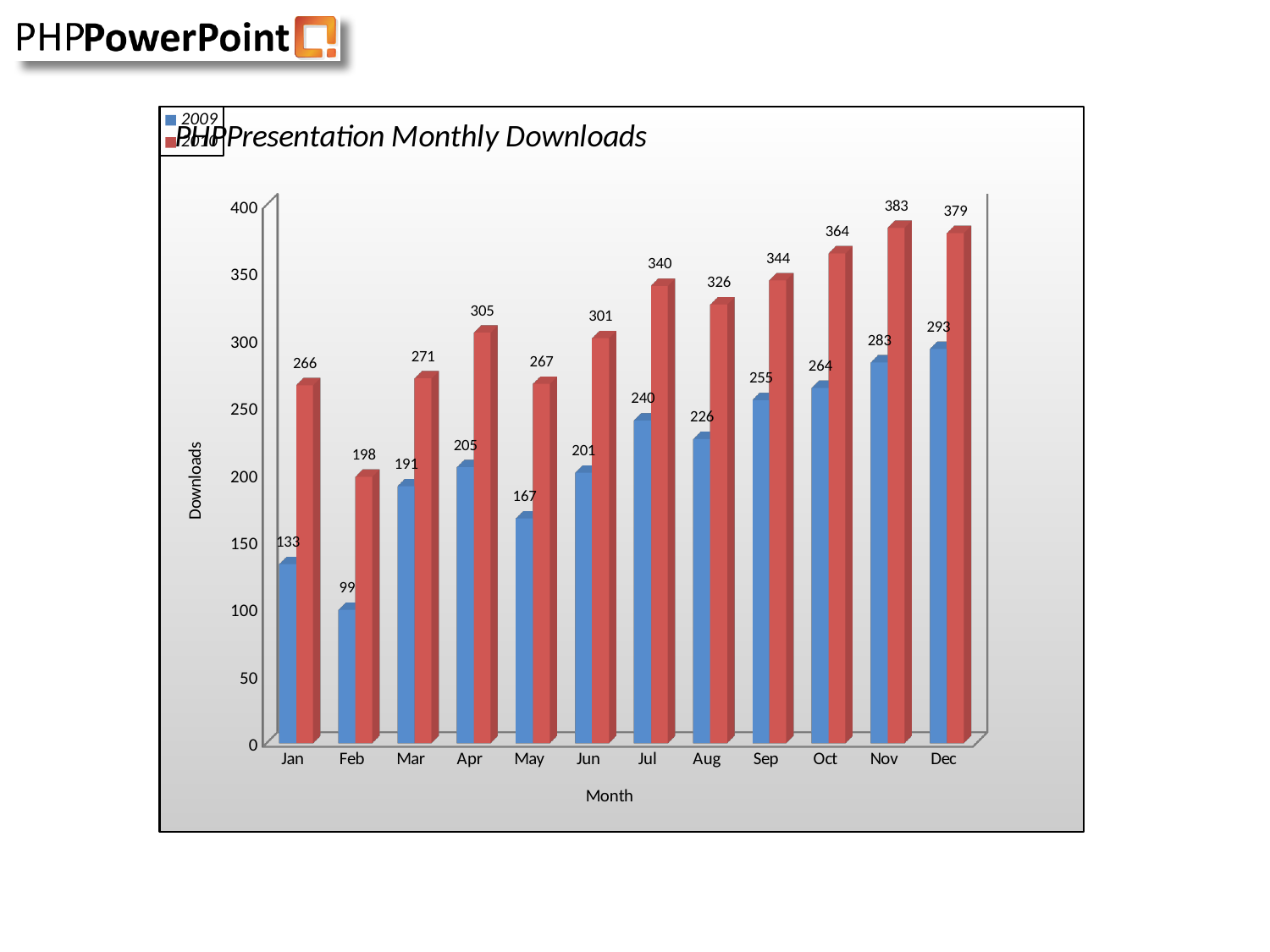
How many months are shown on the x axis? 12 Which month has the highest 2010 value? Nov What is the difference between the 2010 and 2009 values for Jan? 133 What is the title of the chart? PHPPresentation Monthly Downloads How many series does the legend list? 2 What kind of chart is shown? bar chart Is the 2010 value for Sep greater or less than 300? greater What is the 2010 value for Apr? 305 Which is larger, the 2009 value for Dec or the 2010 value for Feb? 2009 value for Dec What is the 2009 value for Jul? 240 Do the 2010 values generally rise or fall from Jan to Dec? rise Which month has the lowest 2009 value? Feb